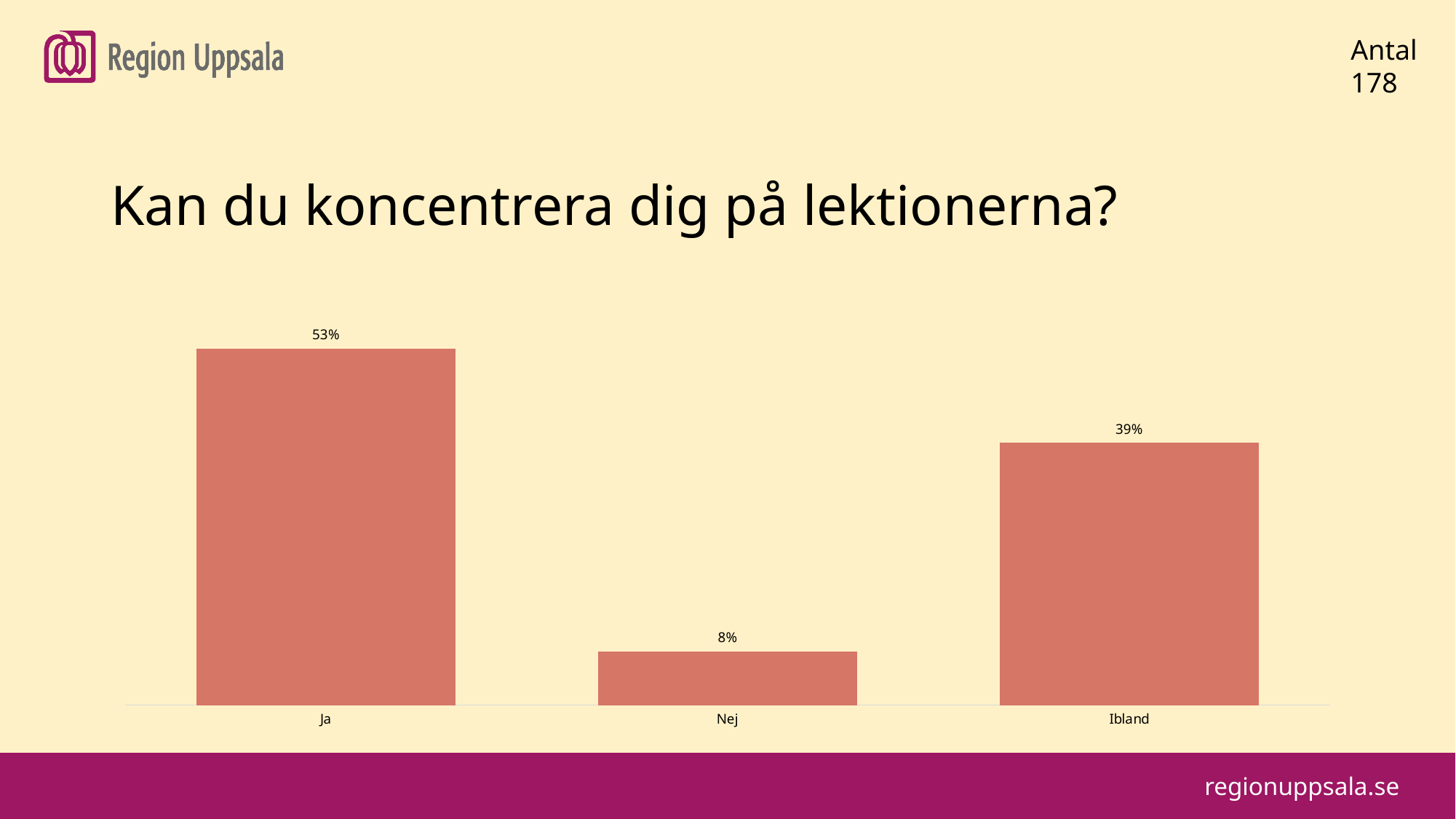
What is the difference between the values for Ja and Ibland? 14% What kind of chart is shown on the slide? Bar chart How many categories are shown in the chart? 3 What is the title of the slide above the chart? Kan du koncentrera dig på lektionerna? What is the value for Ibland? 39% Which is larger, the value for Nej or the value for Ibland? Ibland Which category has the lowest value? Nej What is the difference between the values for Ibland and Nej? 31% Which category has the highest value? Ja What number is shown next to "Antal" in the top right corner of the slide? 178 What is the value for Ja? 53% What is the value for Nej? 8%